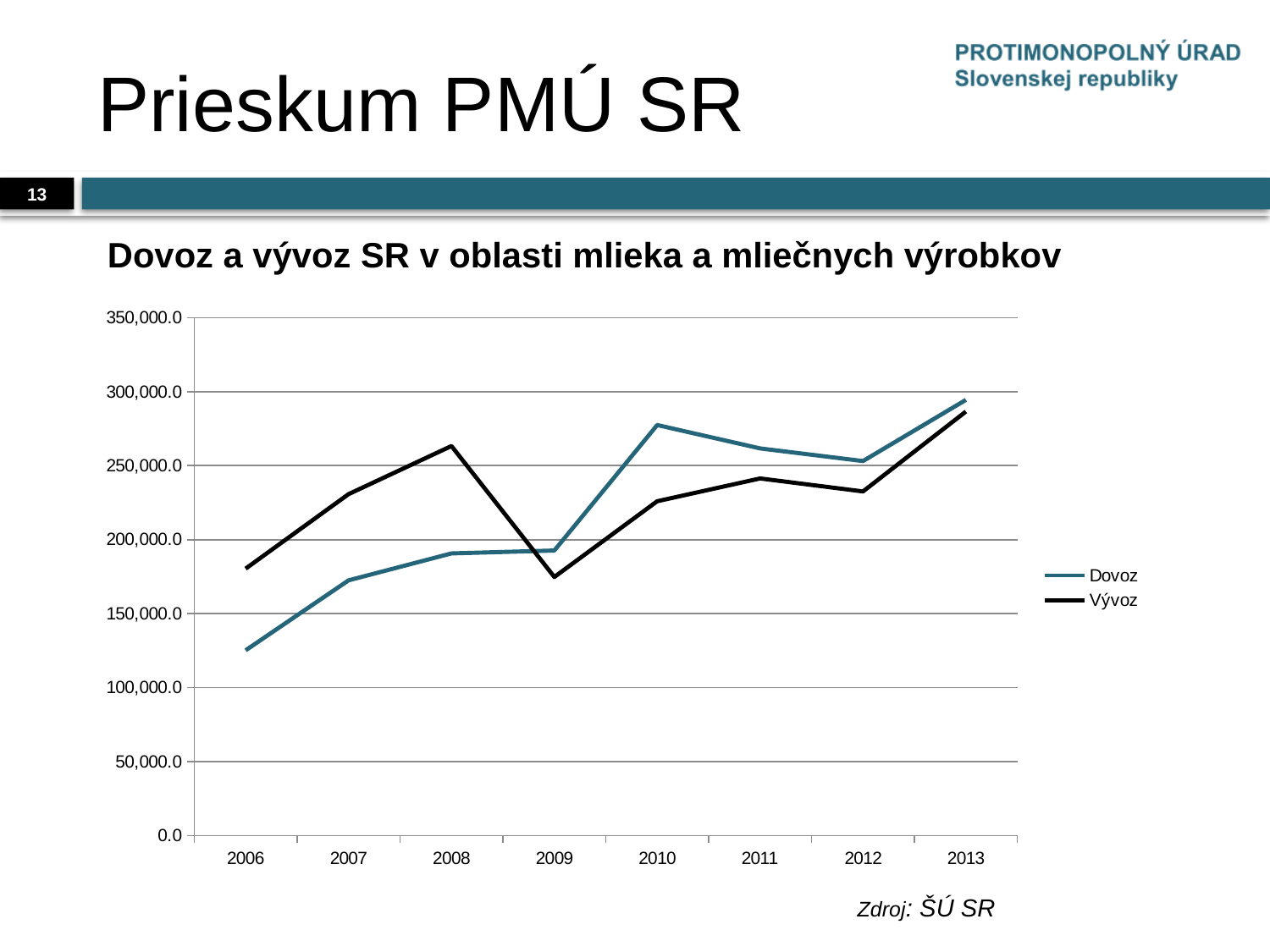
In 2008, which series has the larger value, Dovoz or Vývoz? Vývoz Does the Dovoz series rise or fall from 2006 to 2008? rise Is the value for Vývoz in 2009 greater or less than 200,000.0? less In which year does the Dovoz series have its lowest value? 2006 What type of chart is shown on the slide? line chart Is the value for Vývoz in 2008 greater or less than 250,000.0? greater How many years are shown on the x axis? 8 Is the value for Dovoz in 2006 greater or less than 150,000.0? less In which year does the Vývoz series reach its highest value? 2013 In which year does the Dovoz series reach its highest value? 2013 In 2010, which series has the larger value, Dovoz or Vývoz? Dovoz How many series does the legend list? 2